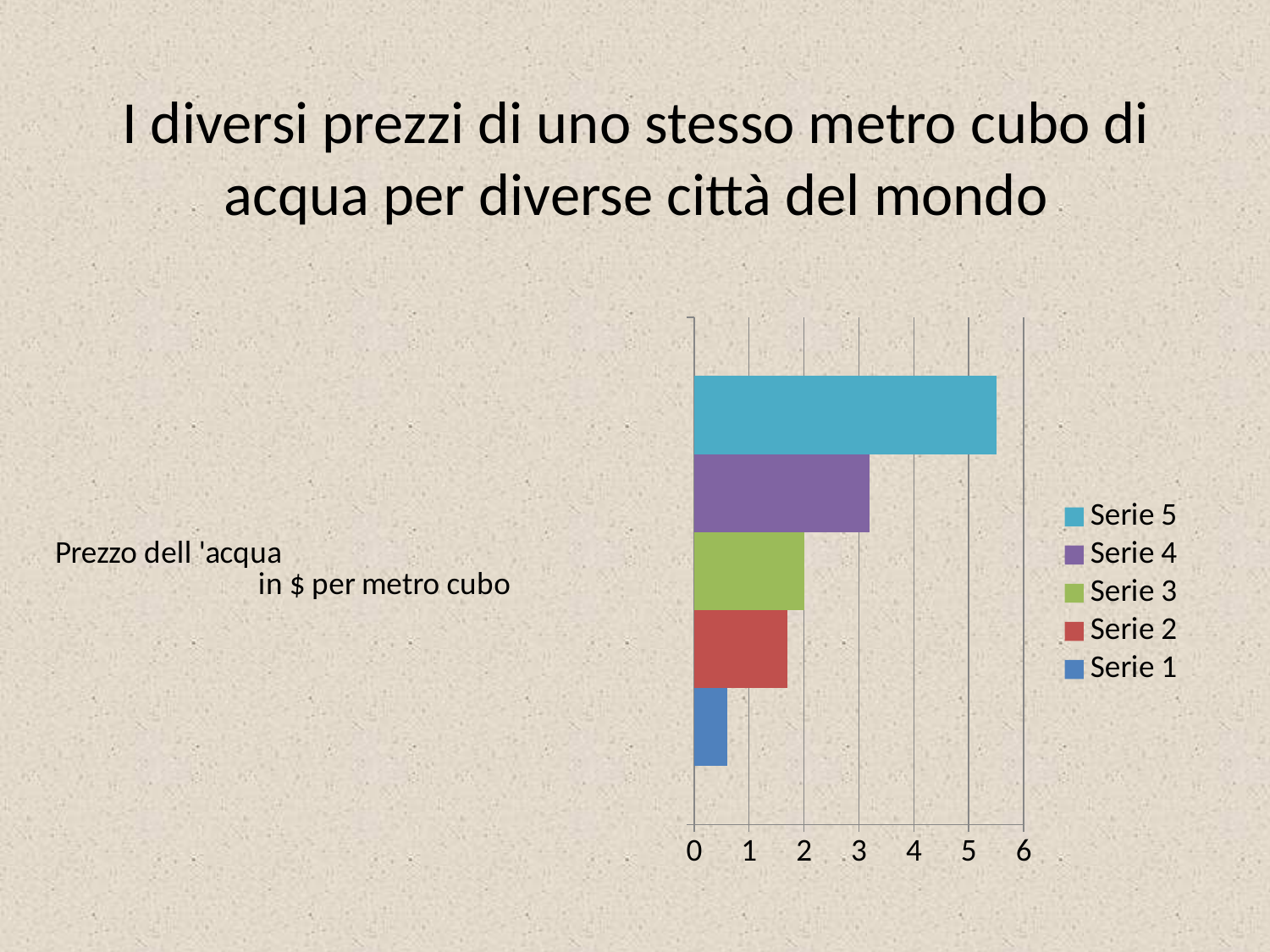
What is the highest value shown on the horizontal axis? 6 Which is larger, the value for Serie 4 or the value for Serie 3? Serie 4 How many series does the legend list? 5 What colour is the bar for Serie 5? light blue Which series has the lowest value? Serie 1 Which is larger, the value for Serie 2 or the value for Serie 1? Serie 2 Is the value for Serie 4 greater or less than 3? greater Is the value for Serie 1 greater or less than 1? less Is the value for Serie 5 greater or less than 5? greater What kind of chart is shown on the slide? bar chart Which series has the highest value? Serie 5